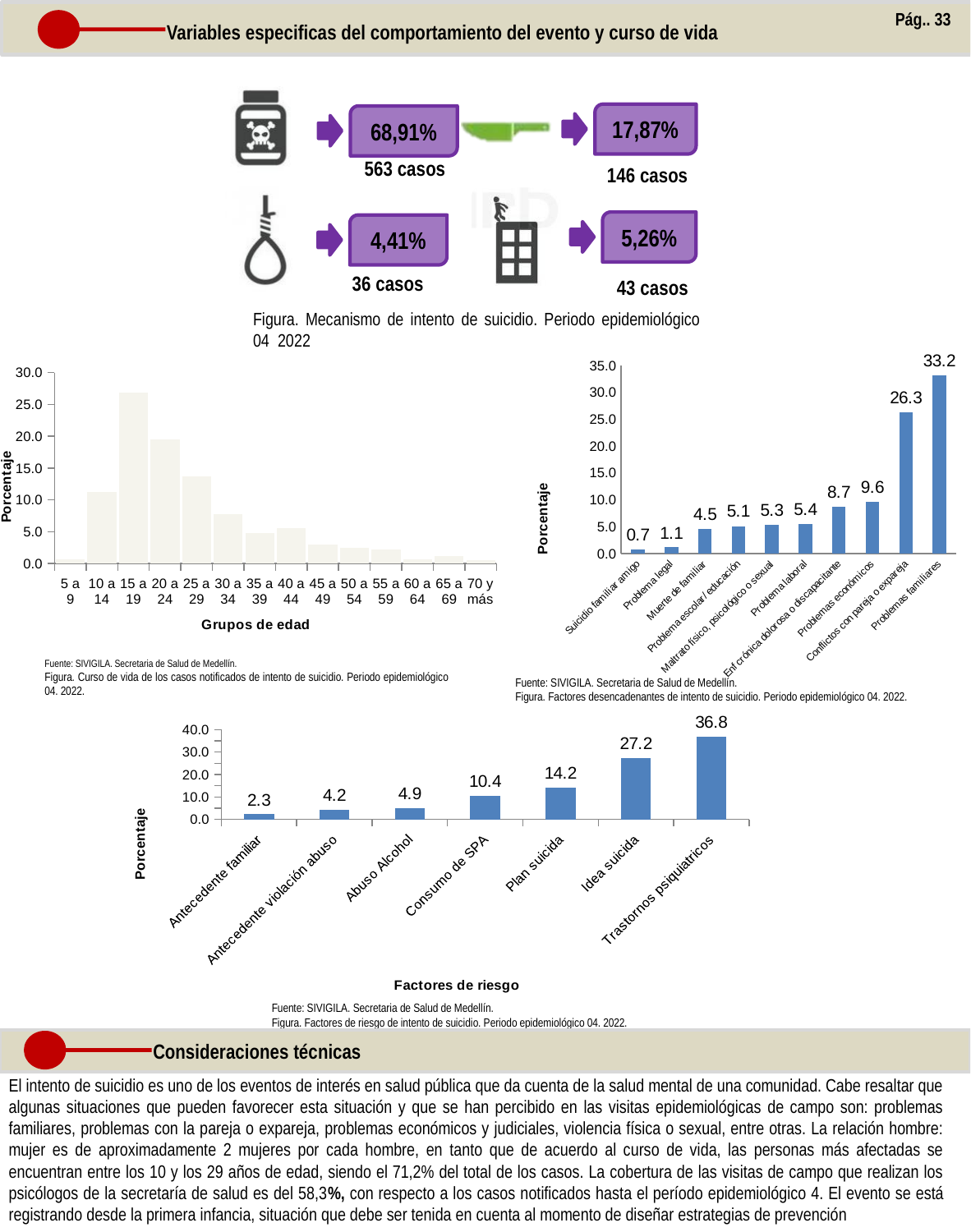
In the 'Grupos de edad' chart (left), is the value for 20 a 24 greater or less than 15.0? greater In the 'Factores de riesgo' chart (bottom), what is the value for Trastornos psiquiatricos? 36.8 In the 'Factores desencadenantes' chart (right), what is the difference between Problemas familiares and Conflictos con pareja o expareja? 6.9 In the 'Grupos de edad' chart (left), which age group has the highest value? 15 a 19 In the 'Factores desencadenantes' chart (right), what is the value for Problemas económicos? 9.6 In the 'Factores desencadenantes' chart (right), what is the value for Problemas familiares? 33.2 In the 'Factores desencadenantes' chart (right), which category has the lowest value? Suicidio familiar amigo In the 'Factores de riesgo' chart (bottom), which is larger, Plan suicida or Idea suicida? Idea suicida In the 'Factores de riesgo' chart (bottom), what is the value for Consumo de SPA? 10.4 In the 'Factores de riesgo' chart (bottom), what is the difference between Idea suicida and Plan suicida? 13.0 In the 'Factores de riesgo' chart (bottom), how many categories are shown? 7 In the 'Factores desencadenantes' chart (right), how many categories are shown? 10